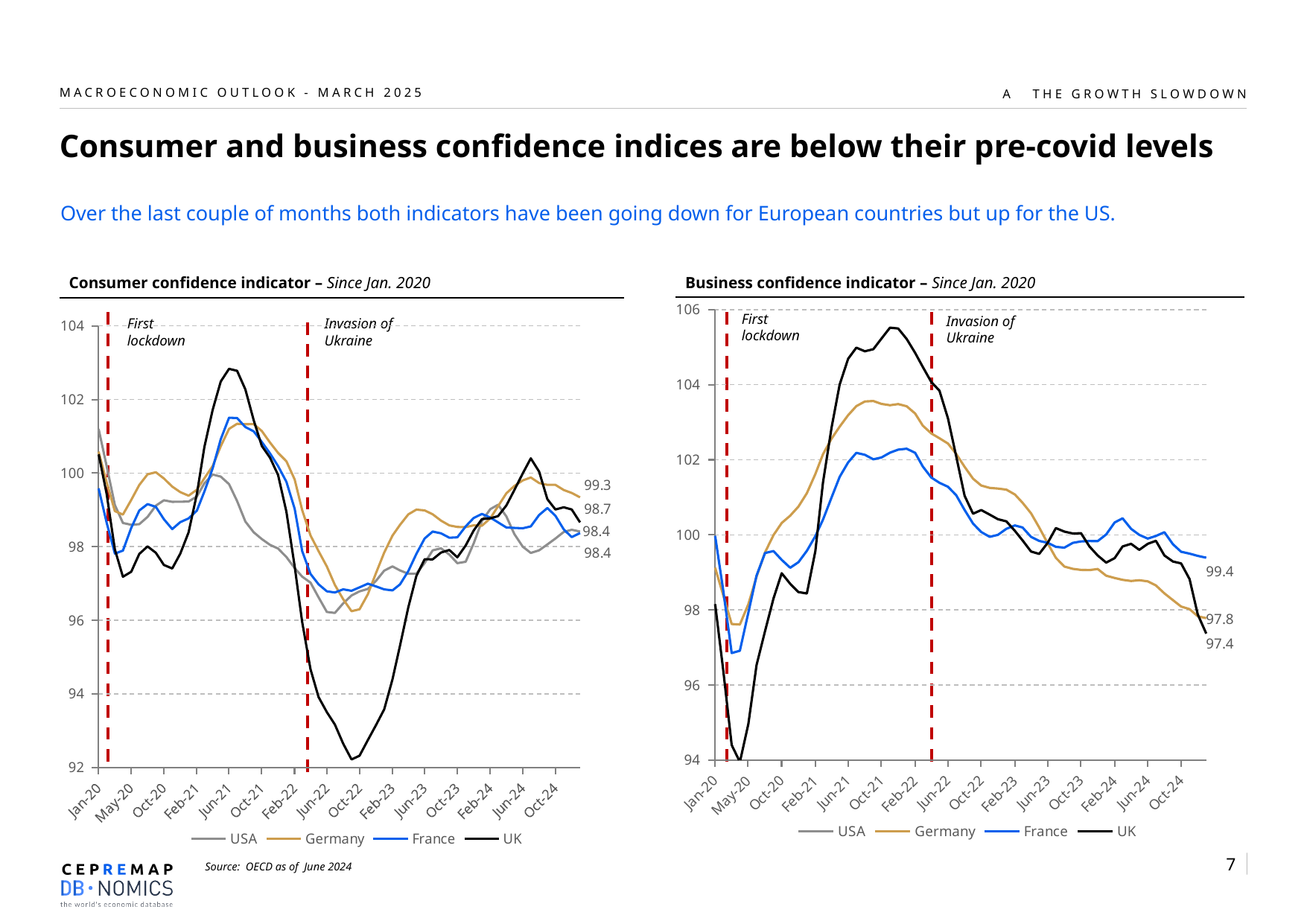
How many series does the legend of the Business confidence indicator chart list? 4 In the Consumer confidence indicator chart, is the lowest value reached by the UK line greater or less than 94? less In the Business confidence indicator chart, is the peak value of the UK line greater or less than 104? greater In the Business confidence indicator chart, what is the latest labelled value for France? 99.4 What type of chart is the Consumer confidence indicator chart? Line chart In the Business confidence indicator chart, what is the difference between the latest labelled values for France and the UK? 2.0 In the Business confidence indicator chart, which has the higher latest labelled value, Germany or the UK? Germany In the Consumer confidence indicator chart, which series has the highest latest labelled value? Germany In the Business confidence indicator chart, what is the latest labelled value for Germany? 97.8 What two events do the red dashed vertical lines mark in the charts? First lockdown and Invasion of Ukraine In the Business confidence indicator chart, what is the latest labelled value for the UK? 97.4 In the Consumer confidence indicator chart, what is the latest labelled value for Germany? 99.3